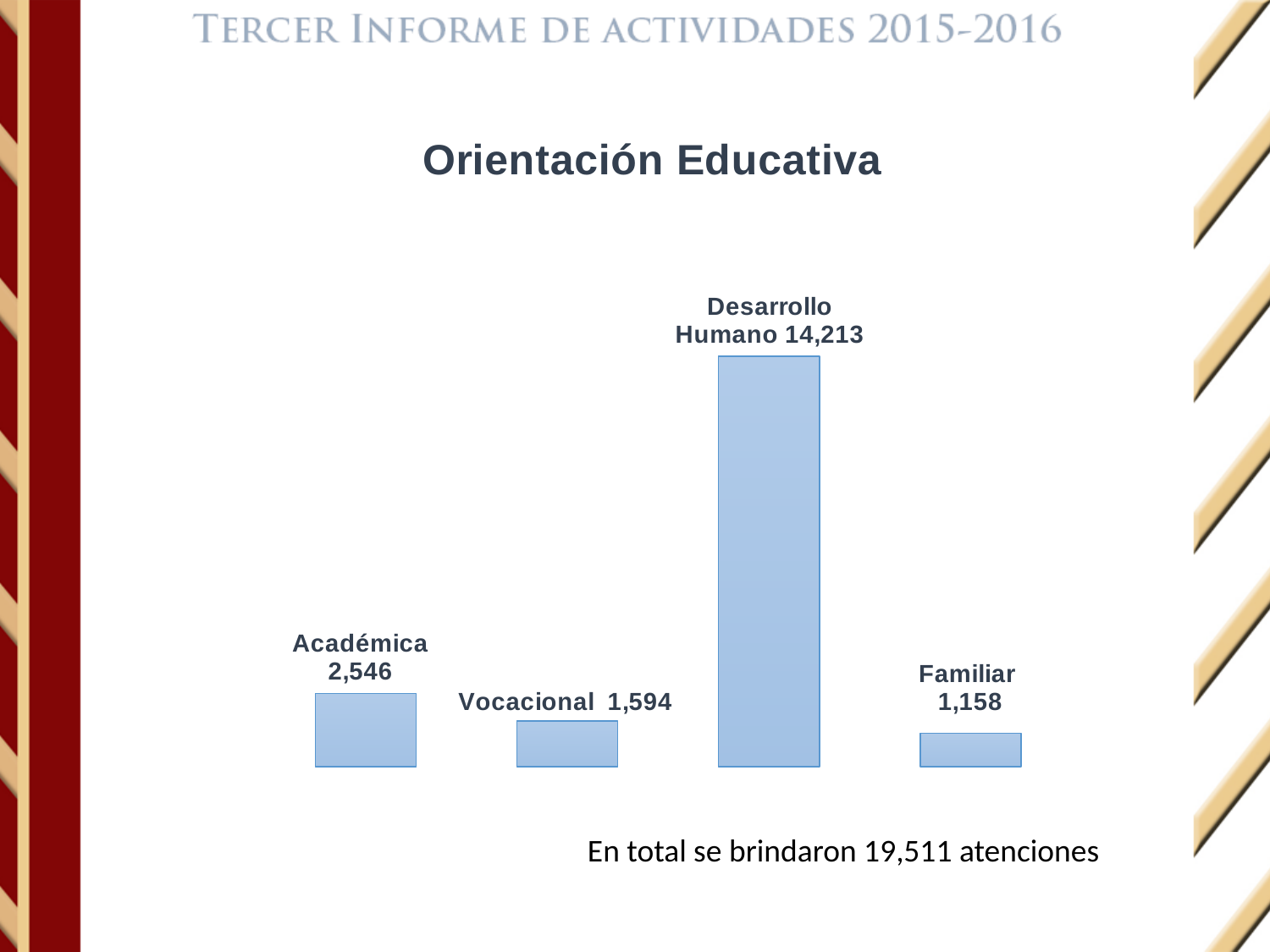
How many categories are shown in the chart? 4 Which category has the highest value? Desarrollo Humano What is the value for Académica? 2,546 What is the value for Familiar? 1,158 What is the difference between the values for Académica and Vocacional? 952 What kind of chart is shown on the slide? Bar chart What is the title of the chart? Orientación Educativa What is the value for Desarrollo Humano? 14,213 Which category has the lowest value? Familiar Which is larger, the value for Vocacional or the value for Familiar? Vocacional What is the difference between the values for Desarrollo Humano and Académica? 11,667 What is the value for Vocacional? 1,594